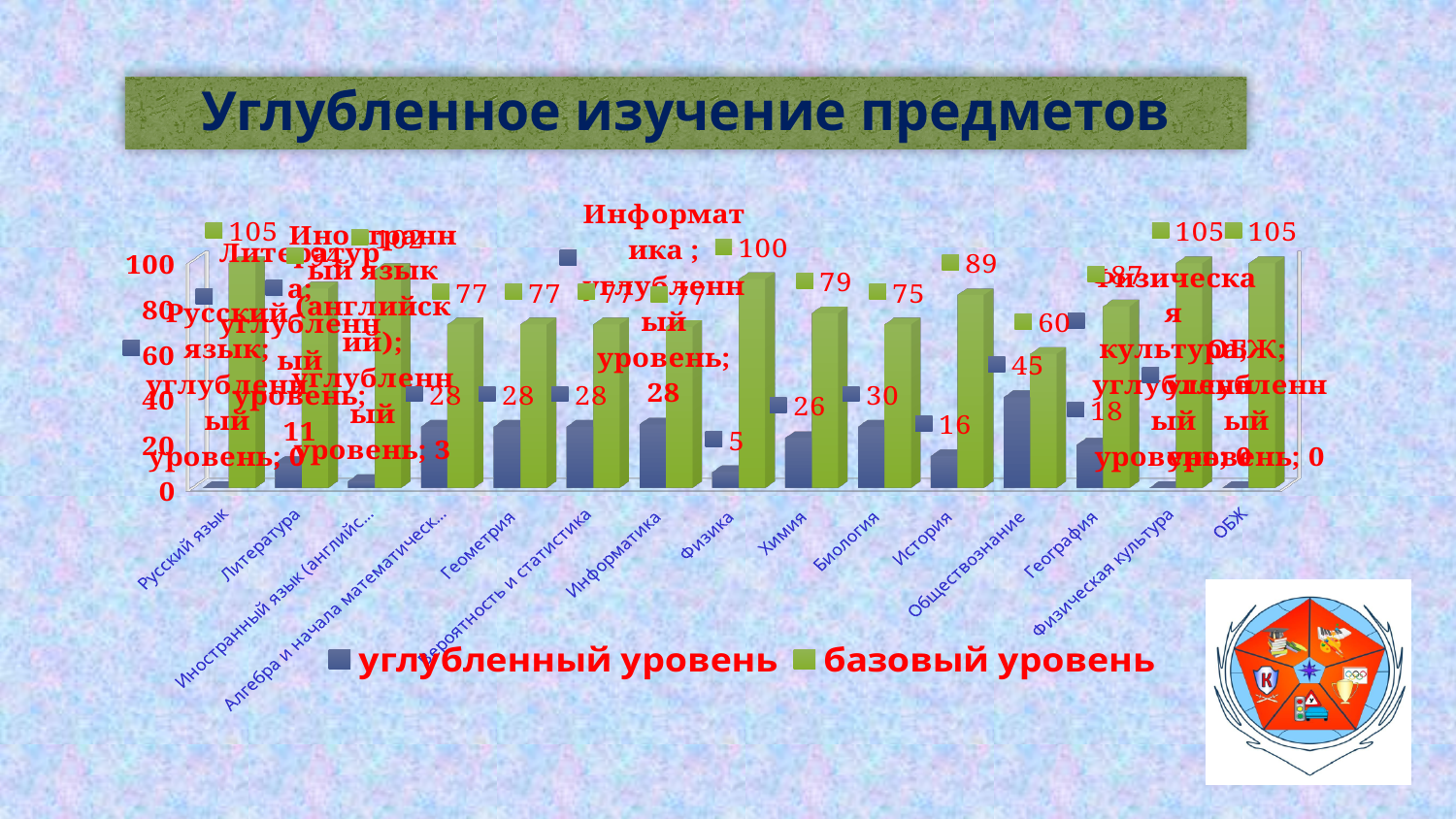
What is the value of углубленный уровень for Химия? 26 Which subject has the highest value for углубленный уровень? Обществознание What is the difference between базовый уровень and углубленный уровень for Биология? 45 Which subject has the lowest value for базовый уровень? Обществознание How many subject categories are shown on the x axis? 15 What is the value of базовый уровень for История? 89 What kind of chart is shown on the slide? bar chart What is the title of the chart? Углубленное изучение предметов Which is larger for География: углубленный уровень or базовый уровень? базовый уровень How many series does the legend list? 2 What is the value of углубленный уровень for Обществознание? 45 What is the value of базовый уровень for Физика? 100